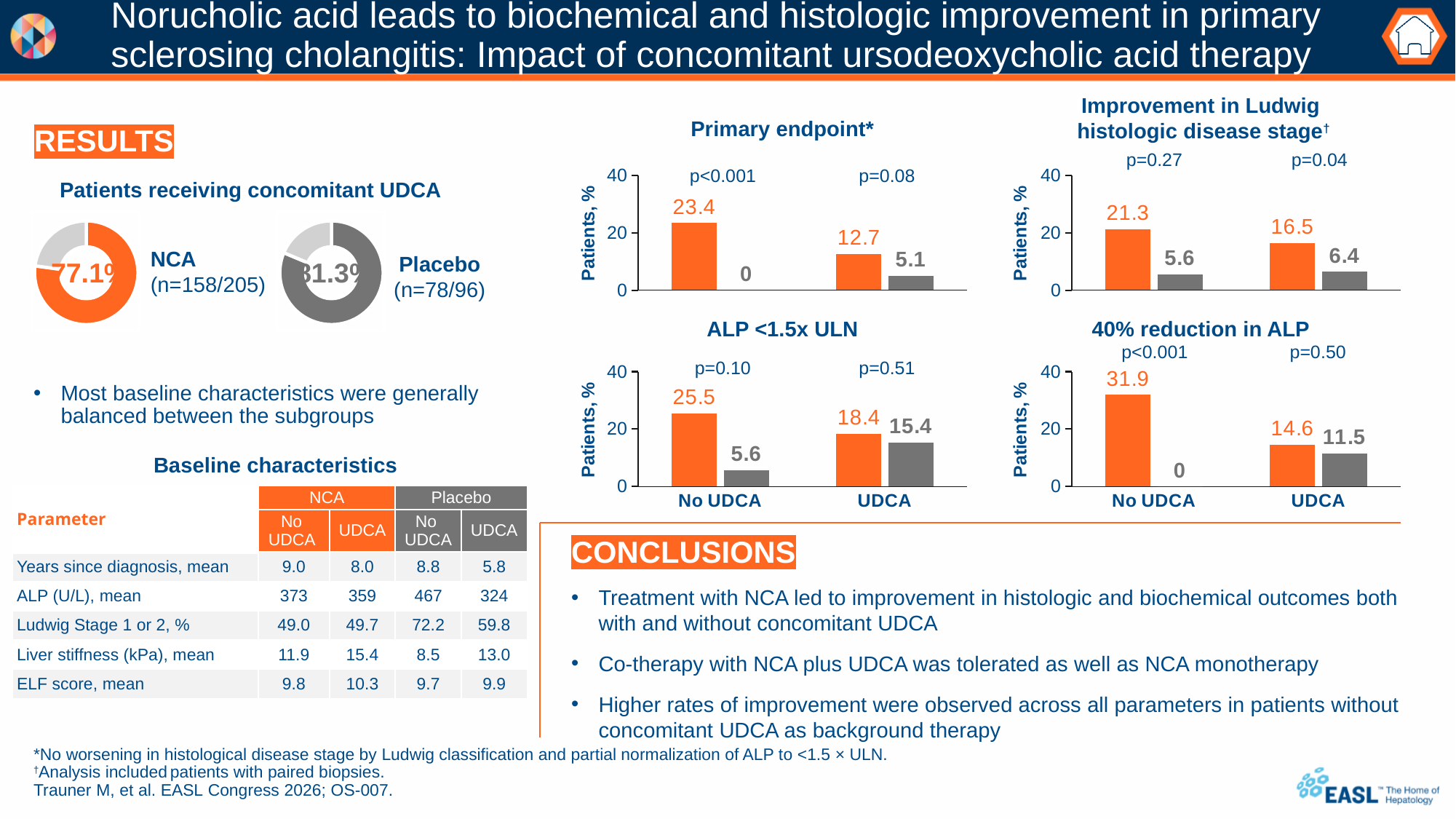
In the 'Primary endpoint*' chart, what is the value of the grey bar for the UDCA group? 5.1 What is the y-axis label on the 'ALP <1.5x ULN' chart? Patients, % In the 'Improvement in Ludwig histologic disease stage' chart, what is the value of the orange bar for the UDCA group? 16.5 In the 'ALP <1.5x ULN' chart, what is the difference between the orange and grey bars in the No UDCA group? 19.9 In the 'Primary endpoint*' chart, what is the difference between the orange and grey bars in the UDCA group? 7.6 What type of chart is used for the 'Primary endpoint*' panel? Bar chart In the '40% reduction in ALP' chart, what is the value of the orange bar for the No UDCA group? 31.9 In the '40% reduction in ALP' chart, which bar is the lowest? No UDCA grey bar (0) In the 'ALP <1.5x ULN' chart, what is the value of the grey bar for the UDCA group? 15.4 In the '40% reduction in ALP' chart, is the orange bar for the No UDCA group greater or less than 20? greater In the 'Primary endpoint*' chart, what is the value of the orange bar for the No UDCA group? 23.4 In the 'Improvement in Ludwig histologic disease stage' chart, which bar is the highest? No UDCA orange bar (21.3)